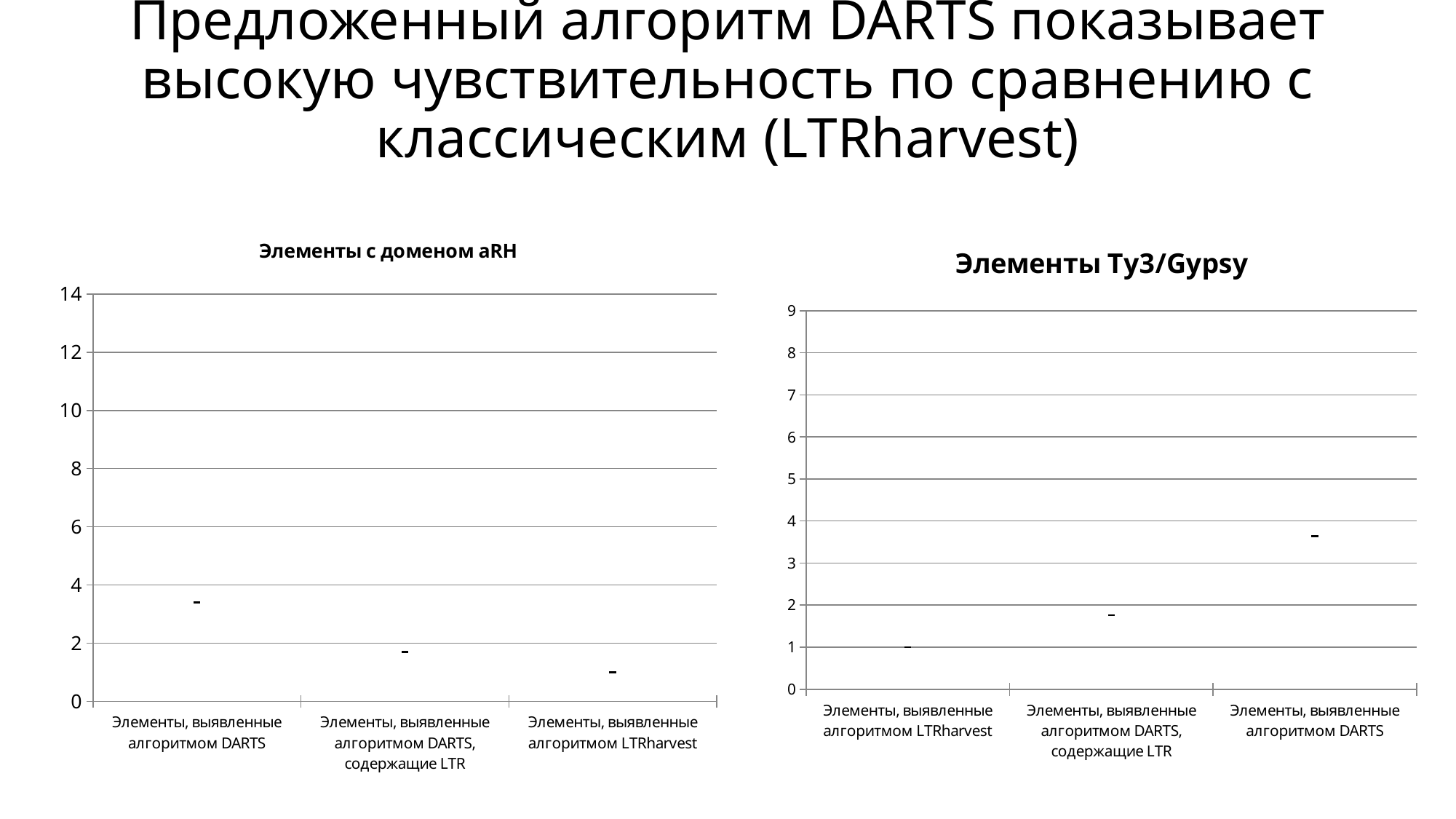
On the chart titled 'Элементы Ty3/Gypsy', is the value for 'Элементы, выявленные алгоритмом DARTS, содержащие LTR' greater or less than 2? less On the chart titled 'Элементы Ty3/Gypsy', which category has the lowest value? Элементы, выявленные алгоритмом LTRharvest On the chart titled 'Элементы с доменом aRH', is the value for 'Элементы, выявленные алгоритмом DARTS' greater or less than 2? greater On the chart titled 'Элементы с доменом aRH', is the value for 'Элементы, выявленные алгоритмом DARTS, содержащие LTR' greater or less than 2? less On the chart titled 'Элементы Ty3/Gypsy', which category has the highest value? Элементы, выявленные алгоритмом DARTS What is the title of the chart on the right side of the slide? Элементы Ty3/Gypsy On the chart titled 'Элементы с доменом aRH', which category has the lowest value? Элементы, выявленные алгоритмом LTRharvest On the chart titled 'Элементы с доменом aRH', how many categories are shown on the x axis? 3 On the chart titled 'Элементы с доменом aRH', which category has the highest value? Элементы, выявленные алгоритмом DARTS On the chart titled 'Элементы Ty3/Gypsy', how many categories are shown on the x axis? 3 On the chart titled 'Элементы Ty3/Gypsy', which is larger: the value for 'Элементы, выявленные алгоритмом DARTS' or the value for 'Элементы, выявленные алгоритмом LTRharvest'? Элементы, выявленные алгоритмом DARTS